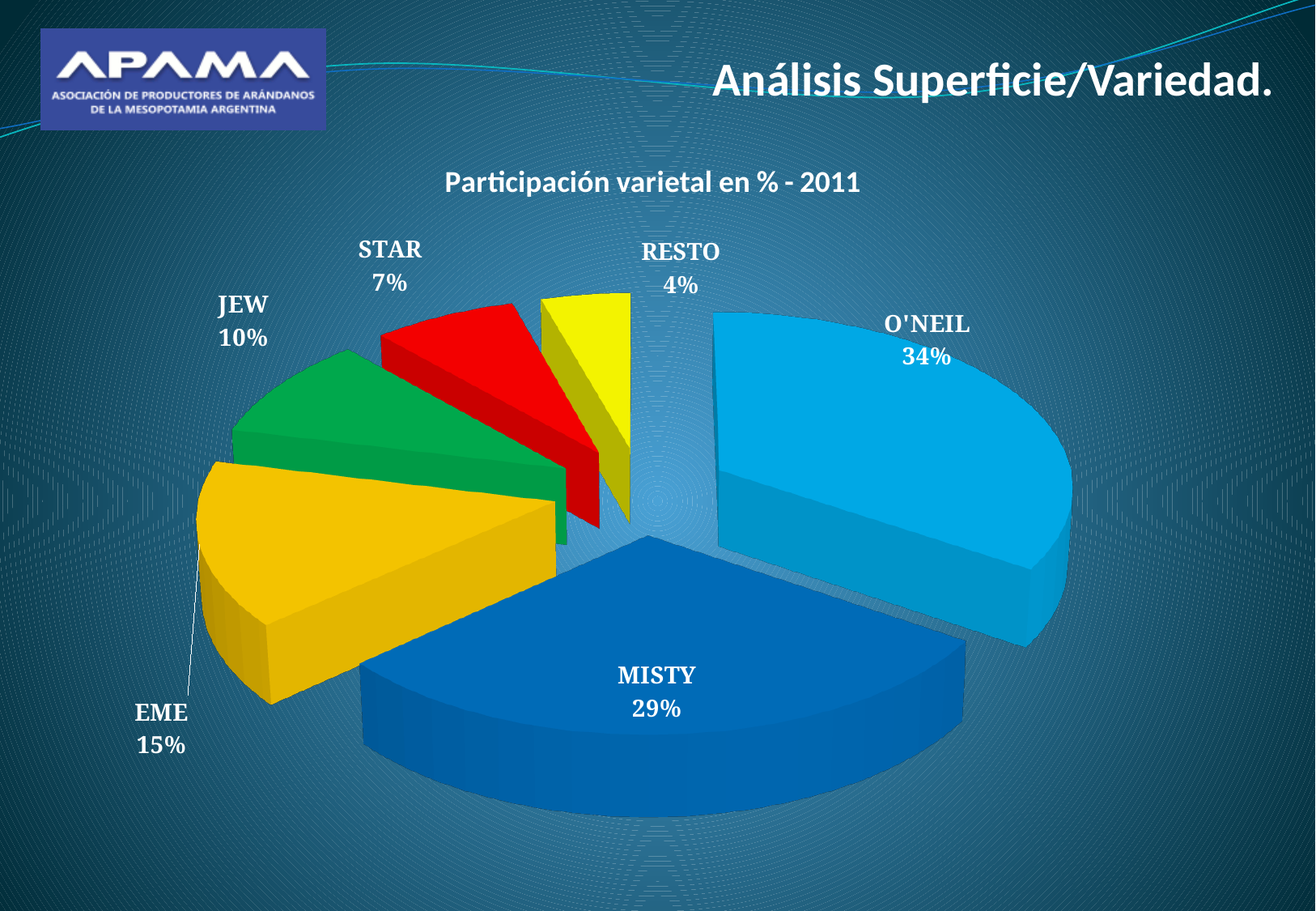
What percentage is shown for MISTY? 29% What is the value for EME? 15% Which is larger, JEW or STAR? JEW What colour is the MISTY slice? Blue Which slice is the smallest? RESTO What is the title of the chart? Participación varietal en % - 2011 Which variety has the largest share of the pie? O'NEIL How many slices does the pie chart have? 6 What share of the pie does O'NEIL have? 34% What is the difference in percentage points between O'NEIL and MISTY? 5 What kind of chart is shown on the slide? Pie chart What percentage does RESTO represent? 4%